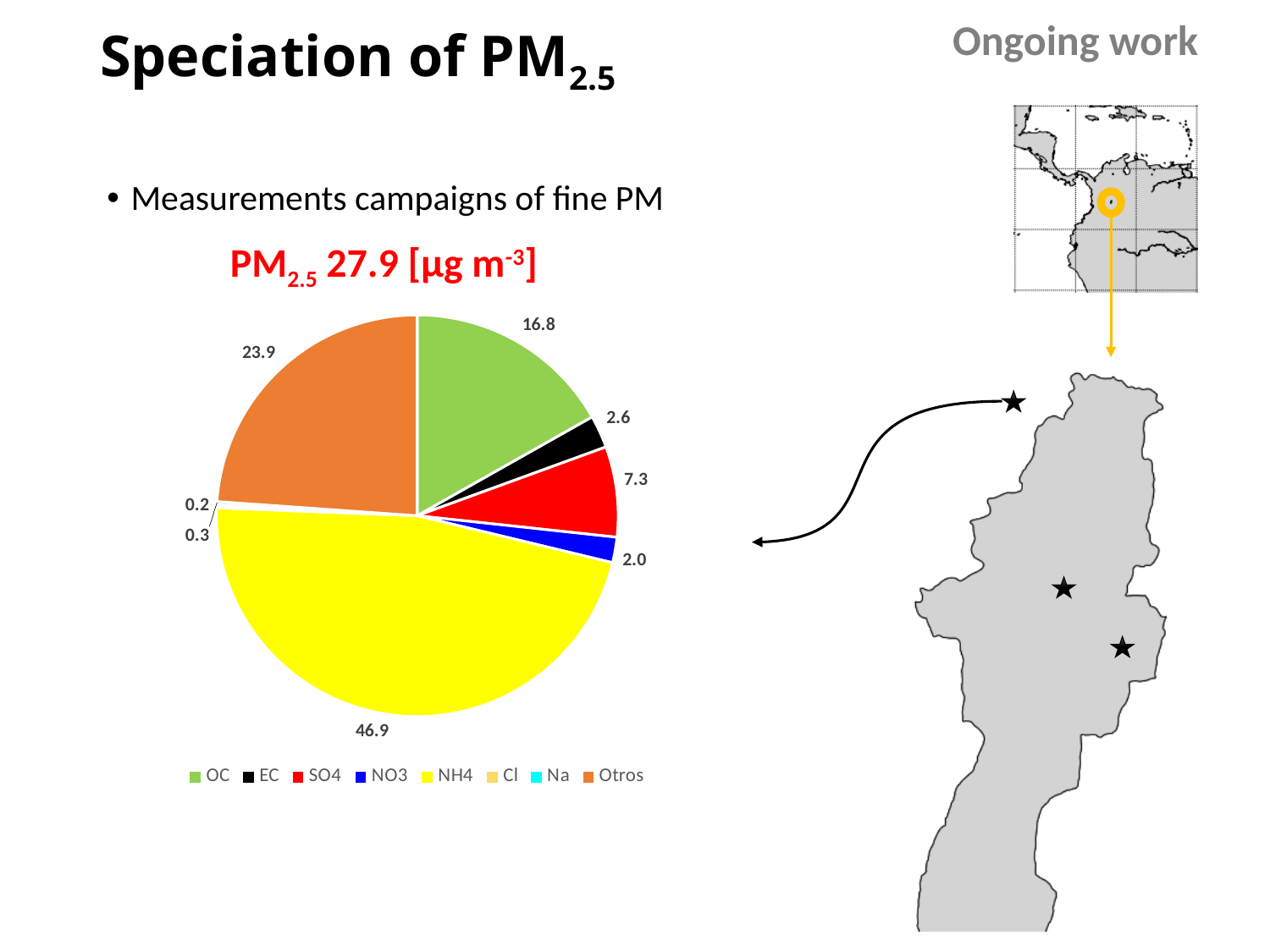
What value is shown for the SO4 slice of the pie chart? 7.3 What colour is the NH4 slice in the pie chart? Yellow What value is shown for the NH4 slice of the pie chart? 46.9 What value is shown for the Otros slice of the pie chart? 23.9 What value is shown for the OC slice of the pie chart? 16.8 What is the difference between the NH4 value and the Otros value in the pie chart? 23.0 Which is larger in the pie chart, the OC slice or the SO4 slice? OC Which category has the smallest slice in the pie chart? Cl Which category has the largest slice in the pie chart? NH4 How many categories does the pie chart's legend list? 8 What value is shown for the NO3 slice of the pie chart? 2.0 What type of chart is shown on the slide? Pie chart